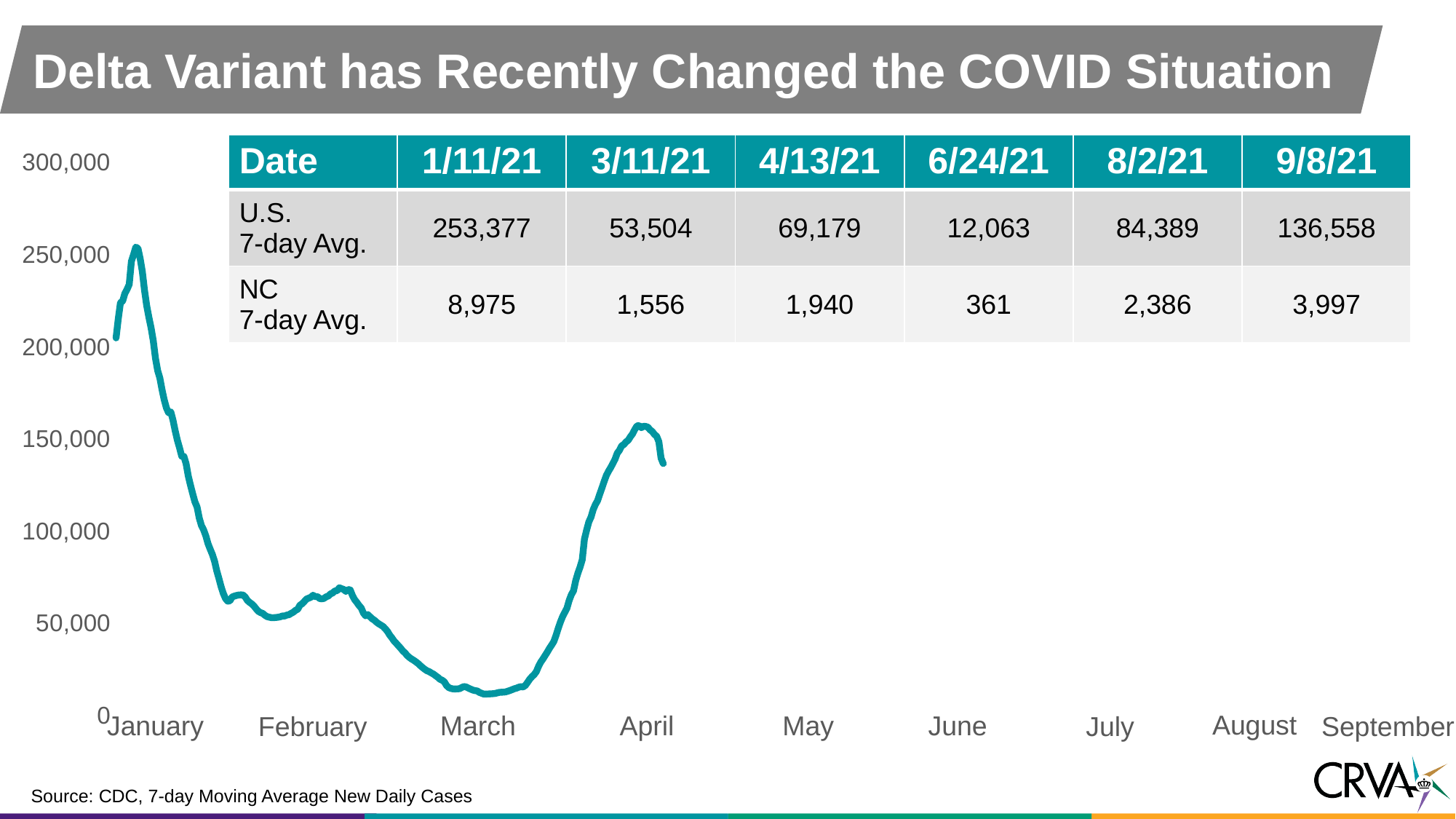
What is the title of the slide? Delta Variant has Recently Changed the COVID Situation How much higher is the U.S. 7-day average on 9/8/21 than on 8/2/21? 52,169 Which date in the table has the highest U.S. 7-day average? 1/11/21 According to the table, what was the NC 7-day average on 6/24/21? 361 What type of chart is shown on the slide? line chart Which is larger: the NC 7-day average on 8/2/21 or on 4/13/21? 8/2/21 According to the table, what was the U.S. 7-day average on 9/8/21? 136,558 How many dates are listed in the table? 6 Which date in the table has the lowest NC 7-day average? 6/24/21 According to the table, what was the U.S. 7-day average on 1/11/21? 253,377 Is the peak value of the line in January greater or less than 200,000? greater What is the difference between the NC 7-day average on 1/11/21 and on 3/11/21? 7,419